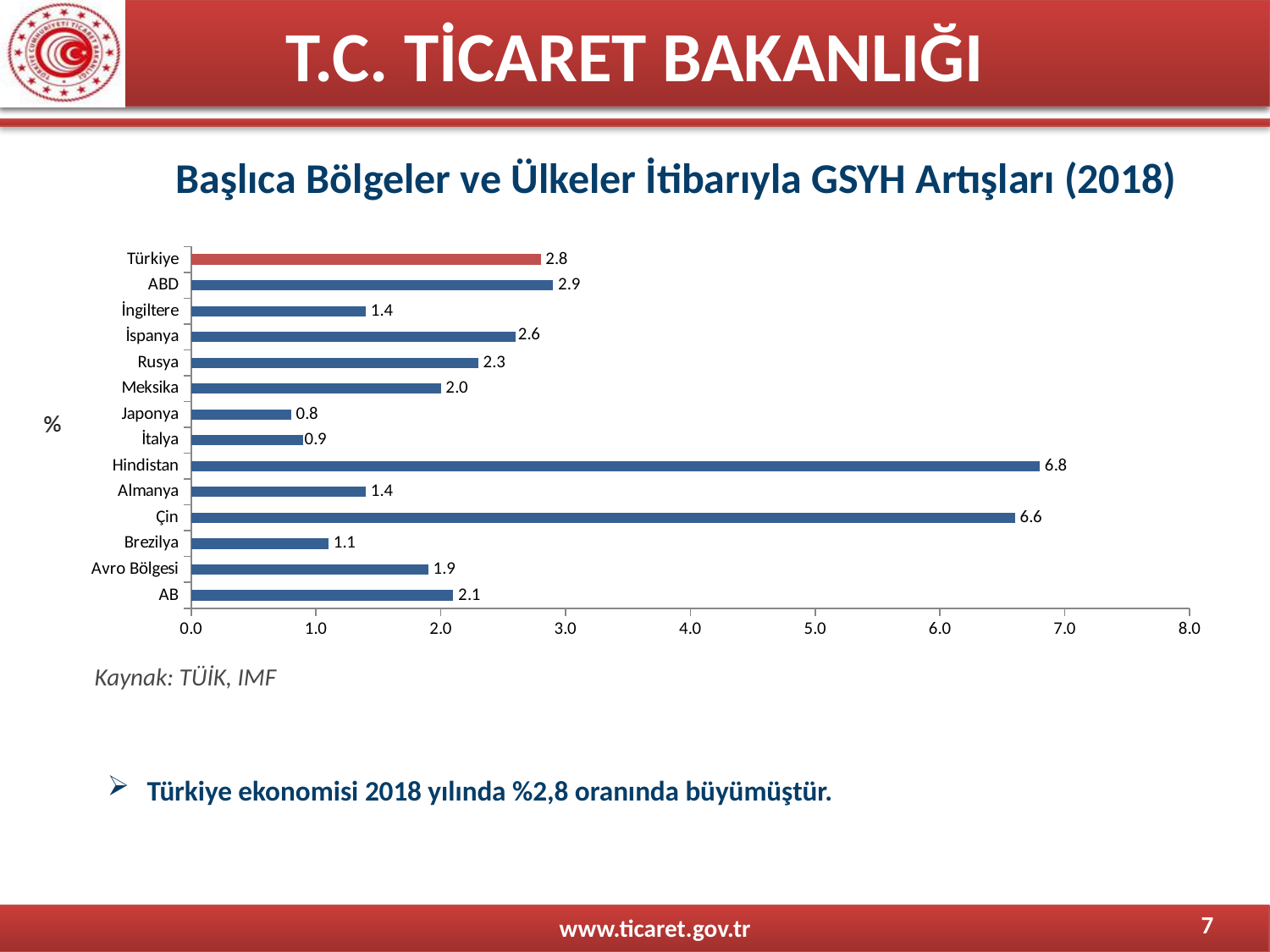
Is the value for Çin greater or less than 6.0? greater Which category has the highest value? Hindistan What is the value shown for Türkiye? 2.8 What is the difference between the values for Hindistan and Çin? 0.2 What is the difference between the values for ABD and Türkiye? 0.1 What is the value shown for Avro Bölgesi? 1.9 What is the GDP growth value shown for Hindistan? 6.8 Which has a larger value, Rusya or Meksika? Rusya Which category has the lowest value? Japonya How many categories are shown in the chart? 14 Which bar is shown in a different colour (red) from the others? Türkiye What kind of chart is shown on the slide? bar chart